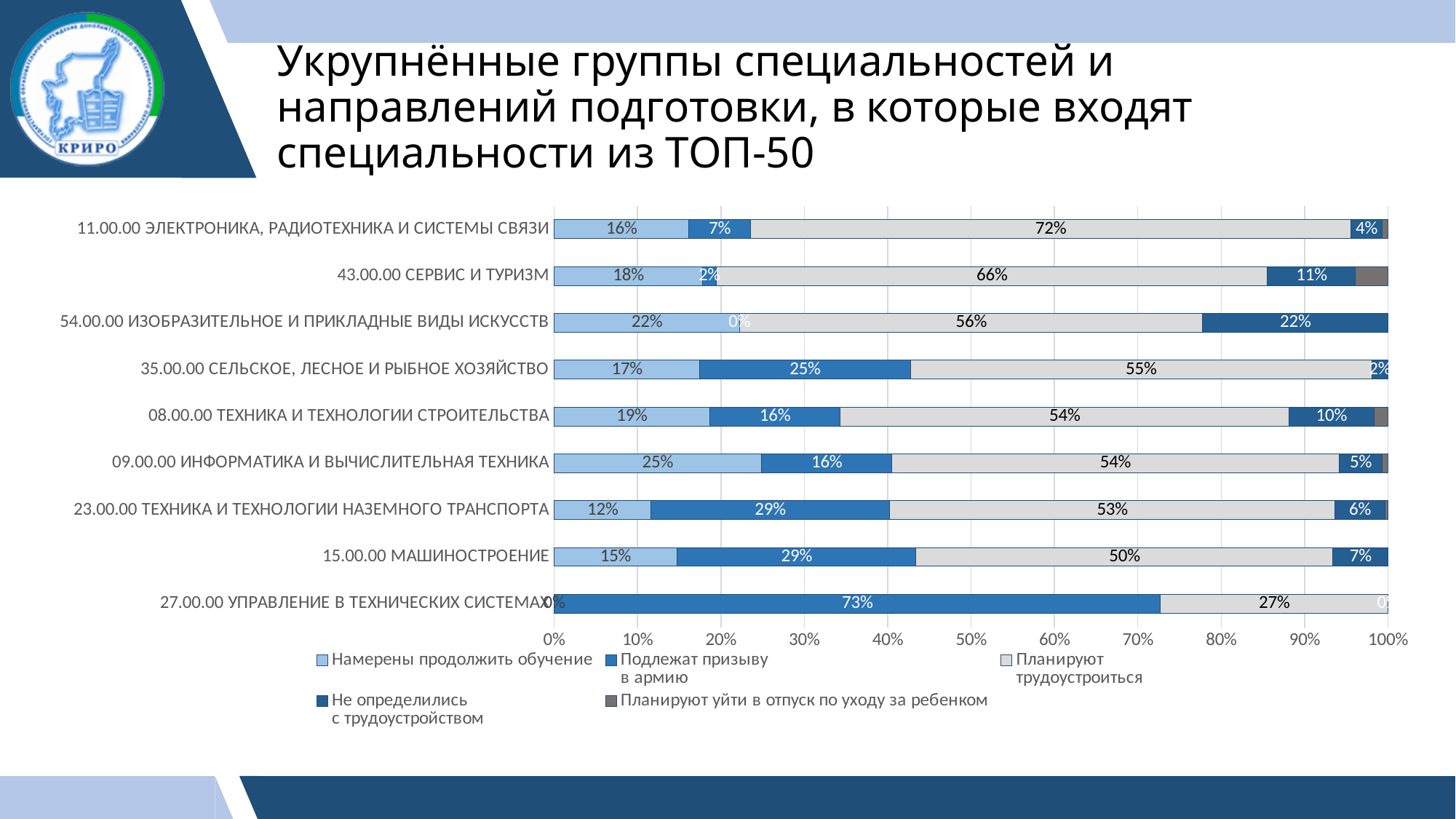
What is the value of 'Не определились с трудоустройством' for 54.00.00 ИЗОБРАЗИТЕЛЬНОЕ И ПРИКЛАДНЫЕ ВИДЫ ИСКУССТВ? 22% Which specialty group has the highest value for 'Планируют трудоустроиться'? 11.00.00 ЭЛЕКТРОНИКА, РАДИОТЕХНИКА И СИСТЕМЫ СВЯЗИ How many series does the legend list? 5 What is the value of 'Намерены продолжить обучение' for 09.00.00 ИНФОРМАТИКА И ВЫЧИСЛИТЕЛЬНАЯ ТЕХНИКА? 25% How many specialty groups (categories) are plotted on the chart? 9 What is the value of 'Планируют трудоустроиться' for 11.00.00 ЭЛЕКТРОНИКА, РАДИОТЕХНИКА И СИСТЕМЫ СВЯЗИ? 72% Which series is shown in light grey in the legend? Планируют трудоустроиться What is the value of 'Подлежат призыву в армию' for 27.00.00 УПРАВЛЕНИЕ В ТЕХНИЧЕСКИХ СИСТЕМАХ? 73% What kind of chart is shown on the slide? Stacked bar chart Which specialty group has the lowest value for 'Планируют трудоустроиться'? 27.00.00 УПРАВЛЕНИЕ В ТЕХНИЧЕСКИХ СИСТЕМАХ Which is larger: the 'Намерены продолжить обучение' value for 43.00.00 СЕРВИС И ТУРИЗМ or for 23.00.00 ТЕХНИКА И ТЕХНОЛОГИИ НАЗЕМНОГО ТРАНСПОРТА? 43.00.00 СЕРВИС И ТУРИЗМ What is the difference between the 'Подлежат призыву в армию' values for 35.00.00 СЕЛЬСКОЕ, ЛЕСНОЕ И РЫБНОЕ ХОЗЯЙСТВО and 11.00.00 ЭЛЕКТРОНИКА, РАДИОТЕХНИКА И СИСТЕМЫ СВЯЗИ? 18%